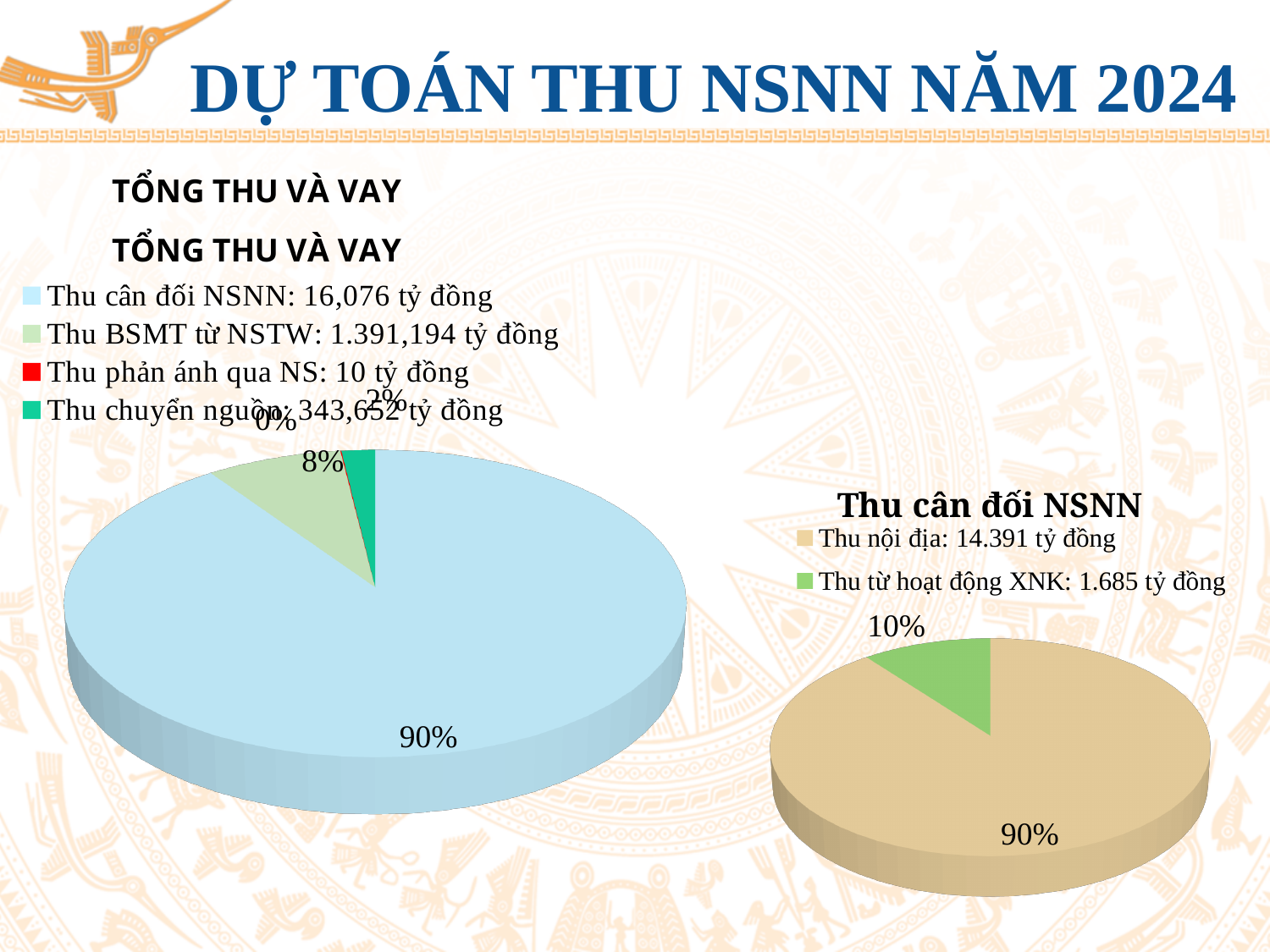
How many categories does the legend of the "TỔNG THU VÀ VAY" chart list? 4 In the "TỔNG THU VÀ VAY" chart, what share does Thu cân đối NSNN have? 90% In the "TỔNG THU VÀ VAY" chart, what share does Thu chuyển nguồn have? 2% What type of chart is the "TỔNG THU VÀ VAY" chart? pie chart How many slices does the "Thu cân đối NSNN" pie chart have? 2 In the "TỔNG THU VÀ VAY" chart, which category has the smallest slice? Thu phản ánh qua NS In the "TỔNG THU VÀ VAY" chart, which category has the largest slice? Thu cân đối NSNN What is the title of the pie chart on the right side of the slide? Thu cân đối NSNN In the "TỔNG THU VÀ VAY" chart, what is the difference in percentage points between Thu BSMT từ NSTW and Thu chuyển nguồn? 6 In the "TỔNG THU VÀ VAY" chart, what share does Thu BSMT từ NSTW have? 8% In the "Thu cân đối NSNN" chart, which category has the larger slice, Thu nội địa or Thu từ hoạt động XNK? Thu nội địa